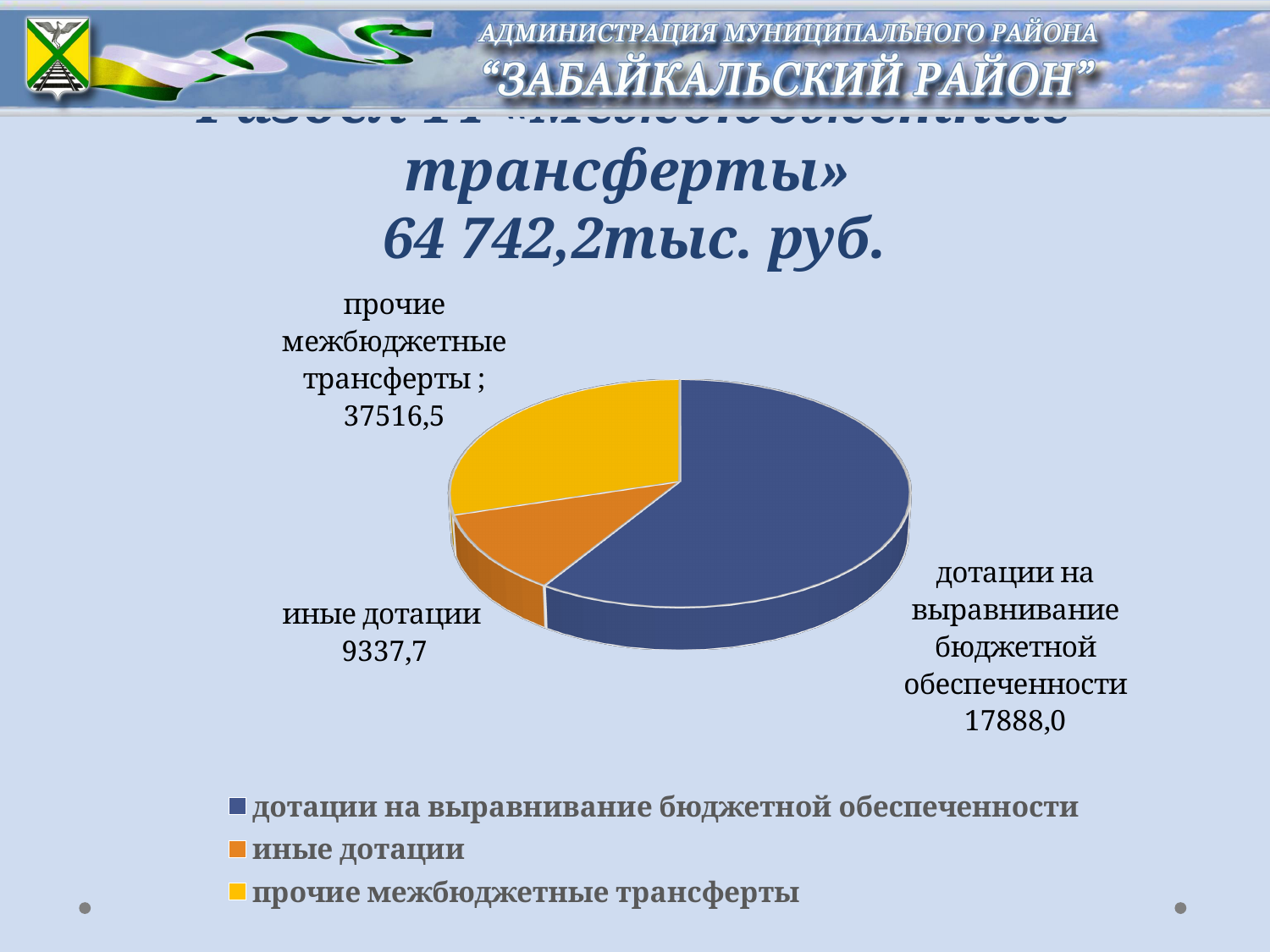
What colour is the slice for «иные дотации» in the pie chart? orange What total amount in thousand rubles is stated in the slide title? 64 742,2тыс. руб. How many categories are shown in the pie chart? 3 What is the difference between «прочие межбюджетные трансферты» and «дотации на выравнивание бюджетной обеспеченности»? 19628,5 What is the value for «дотации на выравнивание бюджетной обеспеченности» in the pie chart? 17888,0 What is the difference between «дотации на выравнивание бюджетной обеспеченности» and «иные дотации»? 8550,3 Which category has the smallest slice of the pie chart? иные дотации What type of chart is shown on the slide? pie chart Which is larger: «дотации на выравнивание бюджетной обеспеченности» or «иные дотации»? дотации на выравнивание бюджетной обеспеченности What is the value for «прочие межбюджетные трансферты» in the pie chart? 37516,5 What is the value for «иные дотации» in the pie chart? 9337,7